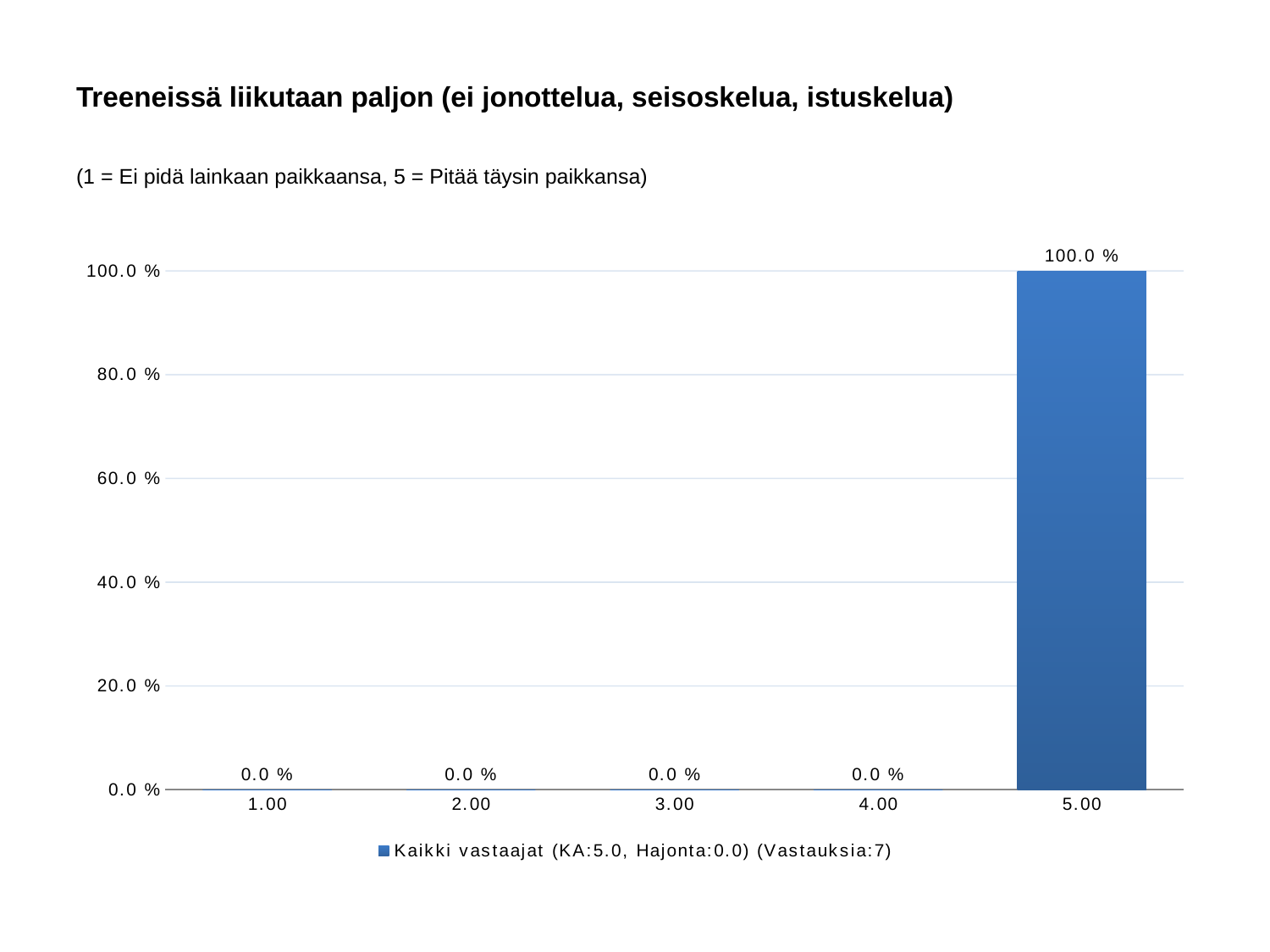
What is the title of the slide? Treeneissä liikutaan paljon (ei jonottelua, seisoskelua, istuskelua) Is the value for 5.00 greater or less than 80.0 %? greater What is the value for category 1.00? 0.0 % What is the value for category 5.00? 100.0 % How many categories are shown on the x axis? 5 What is the legend entry for the series? Kaikki vastaajat (KA:5.0, Hajonta:0.0) (Vastauksia:7) What is the value for category 3.00? 0.0 % What is the difference between the values for 5.00 and 4.00? 100.0 % What kind of chart is shown? bar chart Which category has the highest value? 5.00 Which is larger, the value for 5.00 or the value for 2.00? 5.00 How many series does the legend list? 1